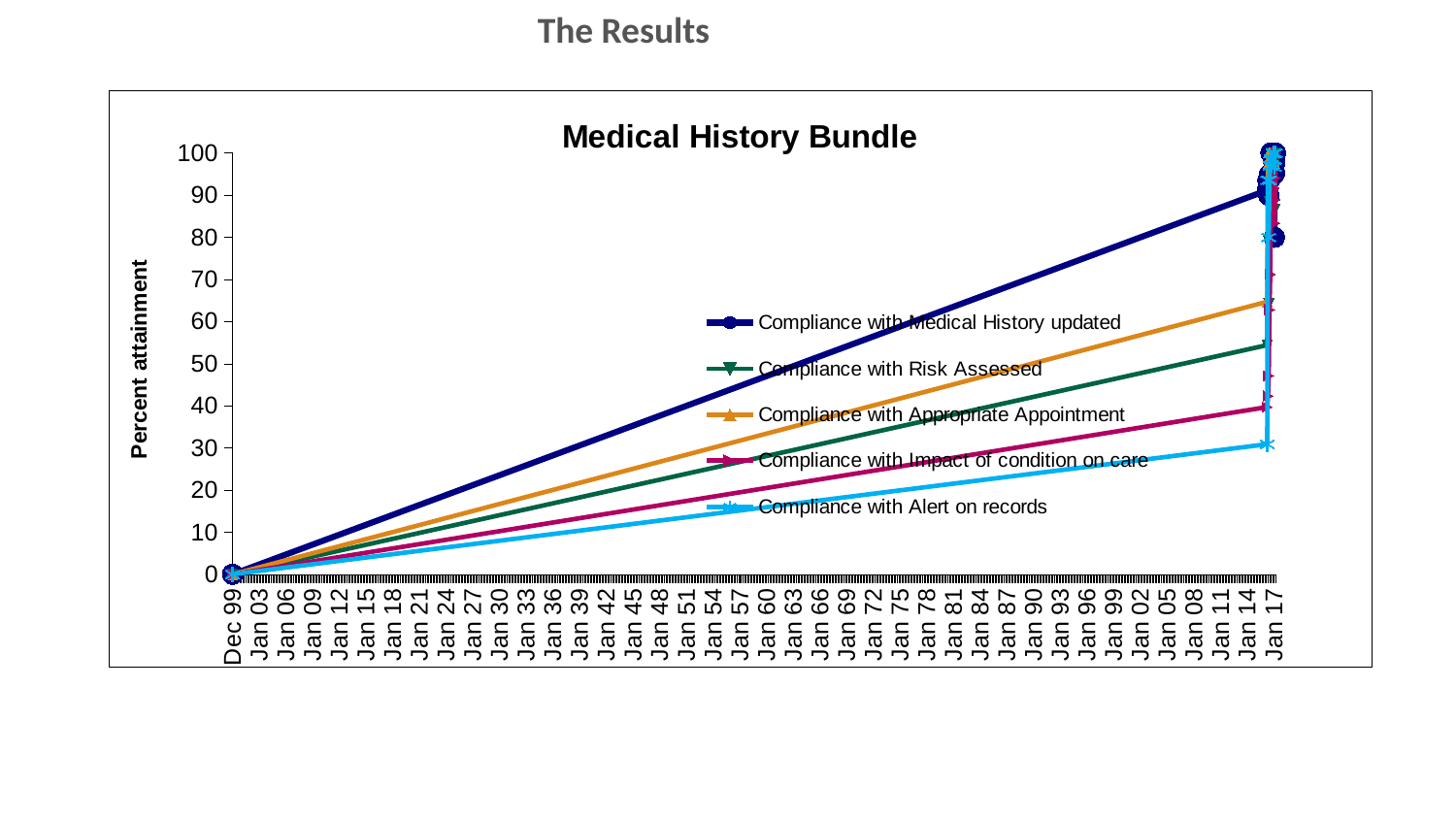
What is the label on the vertical axis? Percent attainment What is the title of the chart? Medical History Bundle What kind of chart is shown on the slide? line chart Is the value reached by the Compliance with Alert on records line at the end of its long rising segment greater or less than 40? less Do the series values rise or fall from left to right across the chart? rise Is the value reached by the Compliance with Risk Assessed line at the end of its long rising segment greater or less than 50? greater At the end of the long rising segments, which is higher: Compliance with Appropriate Appointment or Compliance with Risk Assessed? Compliance with Appropriate Appointment How many series does the legend list? 5 What is the value of the Compliance with Medical History updated series at Dec 99? 0 Is the value reached by the Compliance with Appropriate Appointment line at the end of its long rising segment greater or less than 60? greater Which series has the lowest value at the end of its long rising segment? Compliance with Alert on records